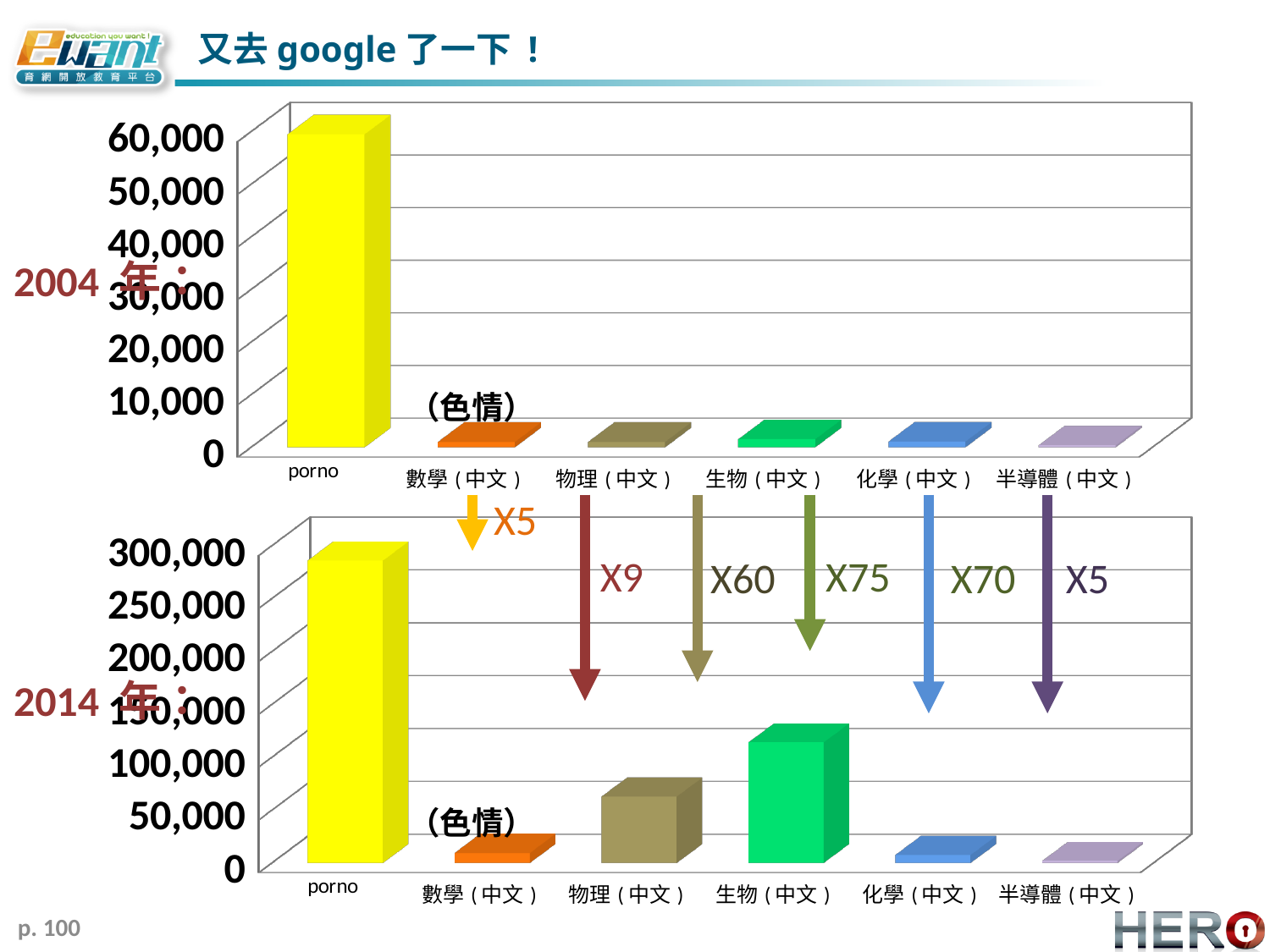
In the bottom chart (2014 年), is the value for 生物 (中文) greater or less than 100,000? greater What multiplier label is shown between the two charts above 生物 (中文)? X75 In the top chart (2004 年), which is larger, the value for porno or the value for 數學 (中文)? porno In the bottom chart (2014 年), which category has the highest value? porno In the bottom chart (2014 年), which is larger, the value for 生物 (中文) or the value for 物理 (中文)? 生物 (中文) In the top chart (2004 年), is the value for porno greater or less than 50,000? greater What is the label of the first category on the x axis of the top chart (2004 年)? porno In the bottom chart (2014 年), is the value for 物理 (中文) greater or less than 100,000? less What kind of chart is the top chart (2004 年)? bar chart In the top chart (2004 年), which category has the highest value? porno How many categories are shown on the x axis of the bottom chart (2014 年)? 6